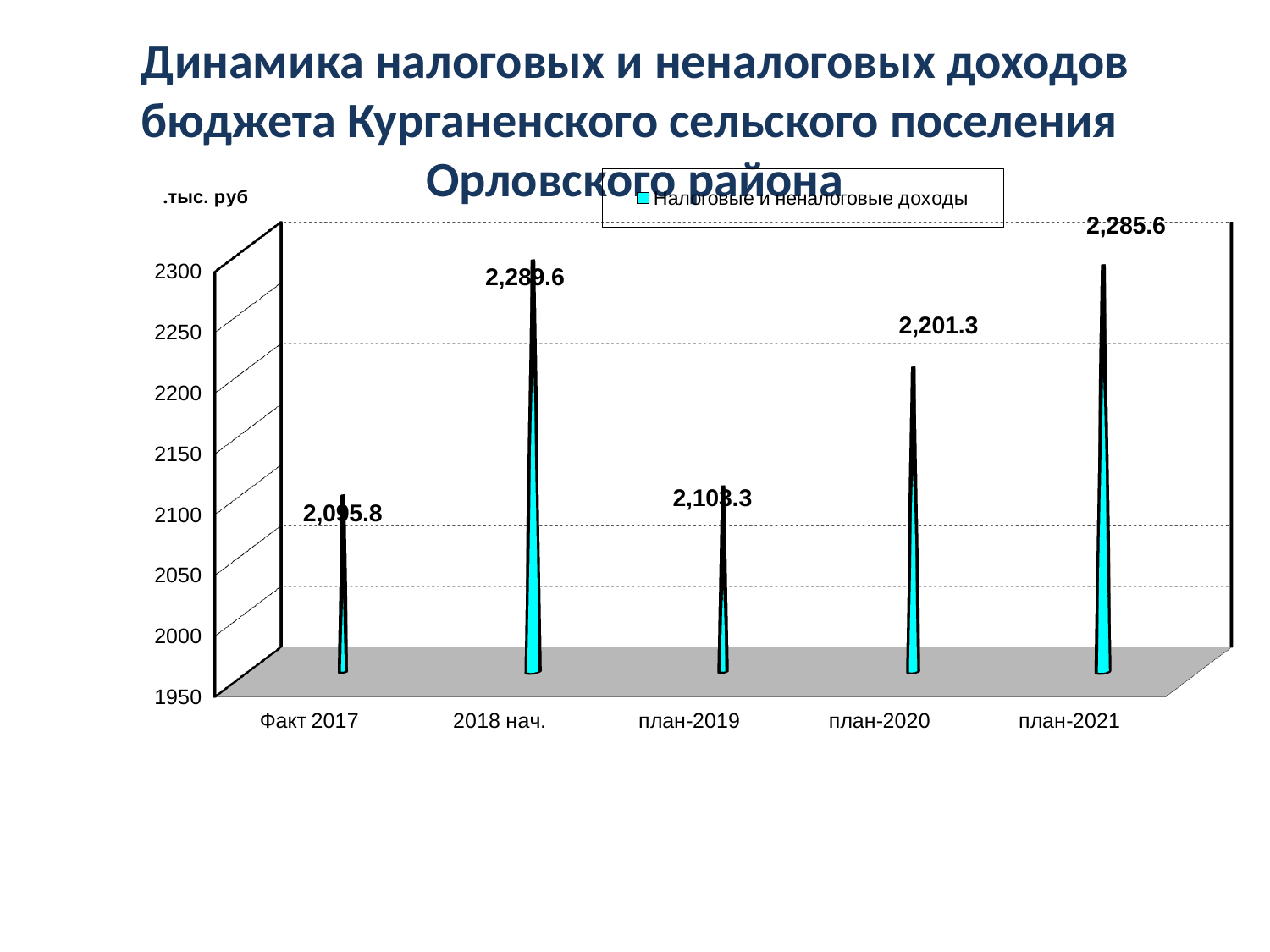
How many categories are shown on the x axis? 5 Which category has the lowest value? Факт 2017 What is the value for план-2021? 2,285.6 Is the value for план-2021 greater or less than 2250? greater Which is larger, the value for план-2021 or the value for Факт 2017? план-2021 What is the difference between the values for план-2021 and план-2020? 84.3 What is the value for план-2020? 2,201.3 Which is larger, the value for план-2020 or the value for план-2019? план-2020 What is the legend entry for the series? Налоговые и неналоговые доходы What kind of chart is shown on the slide? bar chart How many series does the legend list? 1 Is the value for план-2019 greater or less than 2150? less